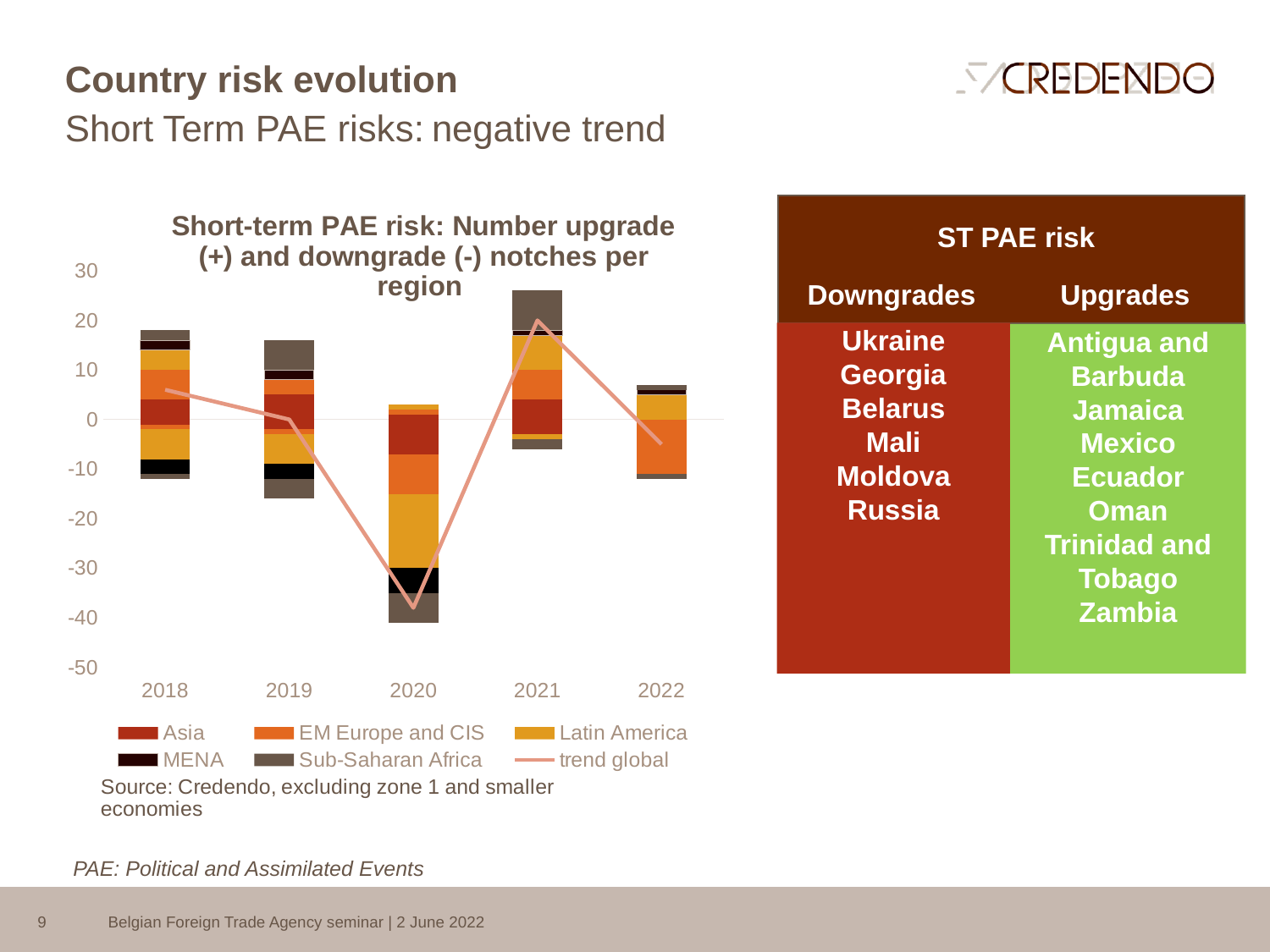
Is the trend global value for 2020 greater or less than -30? less Is the trend global value for 2018 greater or less than 0? greater How many entries does the chart legend list? 6 Does the trend global line rise or fall from 2021 to 2022? fall What kind of chart is shown on the slide? Stacked bar chart with a line What is the title of the chart? Short-term PAE risk: Number upgrade (+) and downgrade (-) notches per region In which year does the trend global line reach its highest value? 2021 How many years are shown on the x axis of the chart? 5 Which series in the chart is drawn as a line rather than bars? trend global In which year does the trend global line reach its lowest value? 2020 Is the top of the positive stacked bar for 2021 greater or less than 20? greater